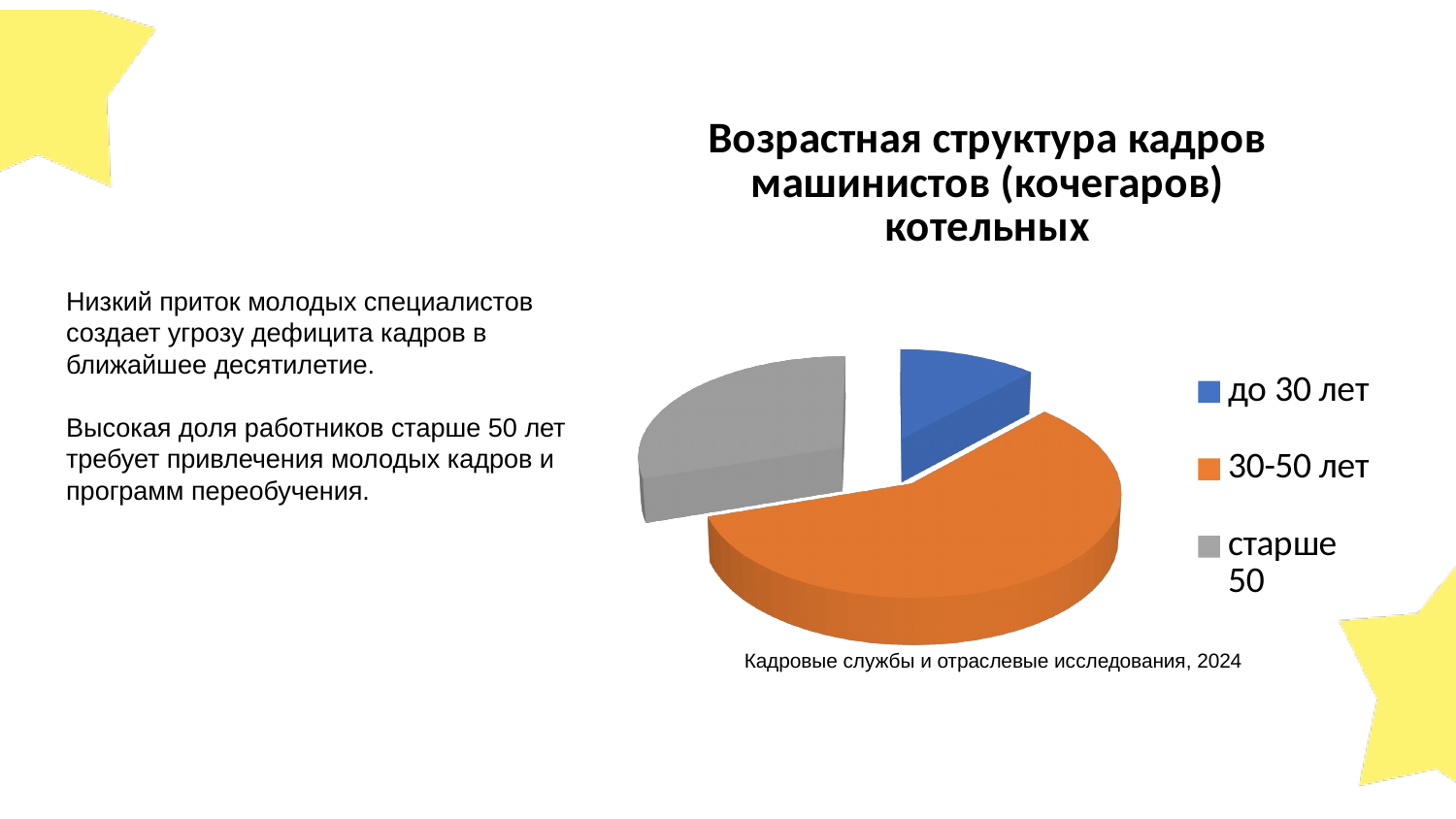
What is the title of the pie chart? Возрастная структура кадров машинистов (кочегаров) котельных Which age group has the largest slice of the pie chart? 30-50 лет Which age group has the smallest slice of the pie chart? до 30 лет How many entries does the legend of the pie chart list? 3 How many slices does the pie chart have? 3 Which slice is larger: "30-50 лет" or "старше 50"? 30-50 лет Which slice is larger: "до 30 лет" or "старше 50"? старше 50 What kind of chart is shown on the slide? pie chart What colour is the slice for "30-50 лет" in the pie chart? orange